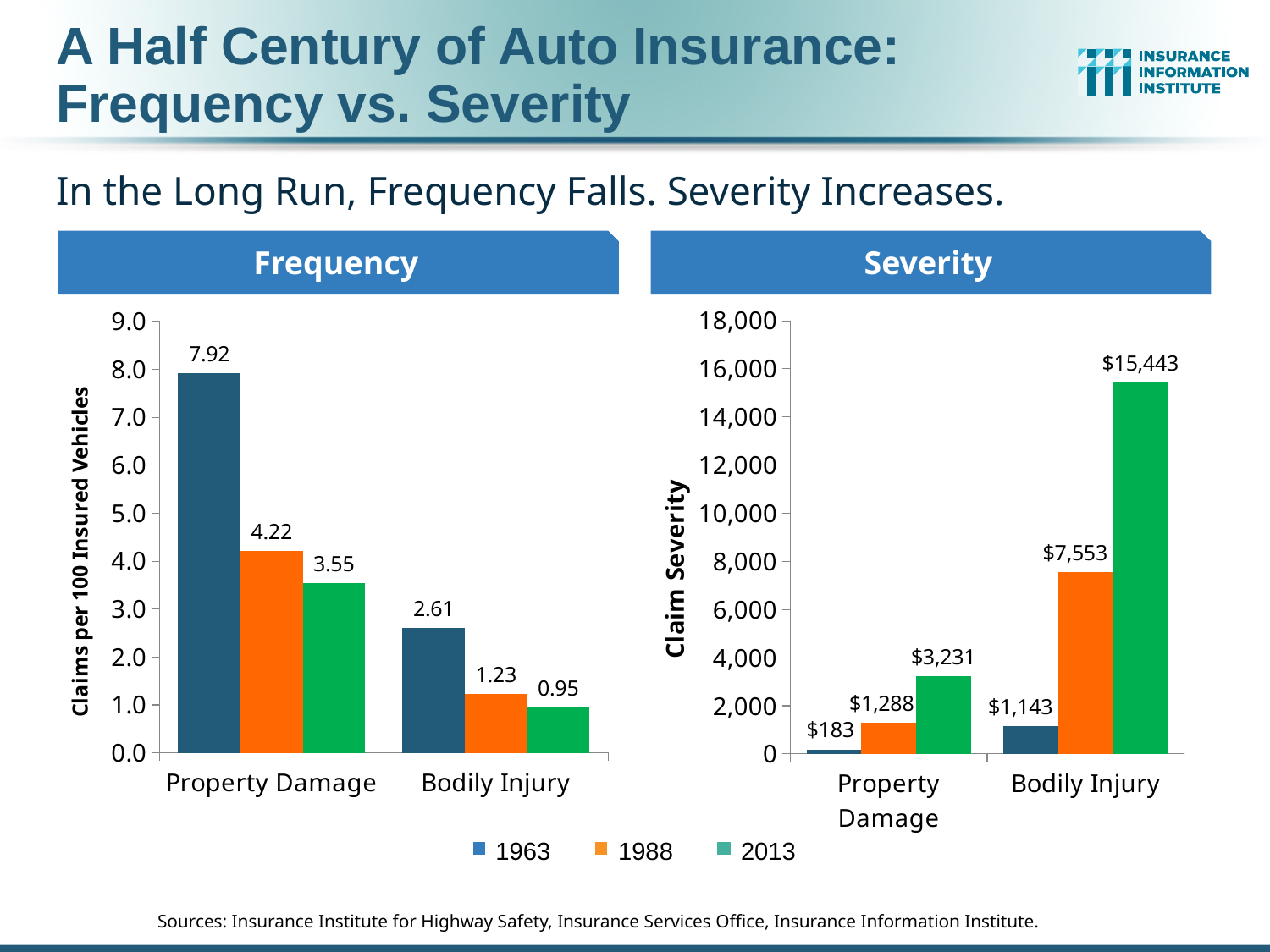
How many series does the legend list? 3 In the Frequency chart, what is the value for Property Damage in 1963? 7.92 In the Severity chart, what is the claim severity for Bodily Injury in 2013? $15,443 In the Severity chart, what is the difference between the 2013 and 1988 claim severity for Bodily Injury? $7,890 In the Frequency chart, do the values for Bodily Injury rise or fall from 1963 to 2013? fall In the Severity chart, which year has the highest claim severity for Bodily Injury? 2013 What kind of chart is the Severity chart? bar chart In the Frequency chart, which is larger: the 1988 value for Property Damage or the 1963 value for Bodily Injury? 1988 value for Property Damage In the Frequency chart, what is the difference between the 1963 and 1988 values for Property Damage? 3.70 In the Frequency chart, what is the value for Bodily Injury in 2013? 0.95 In the Frequency chart, which year has the lowest value for Property Damage? 2013 In the Severity chart, what is the claim severity for Property Damage in 1963? $183